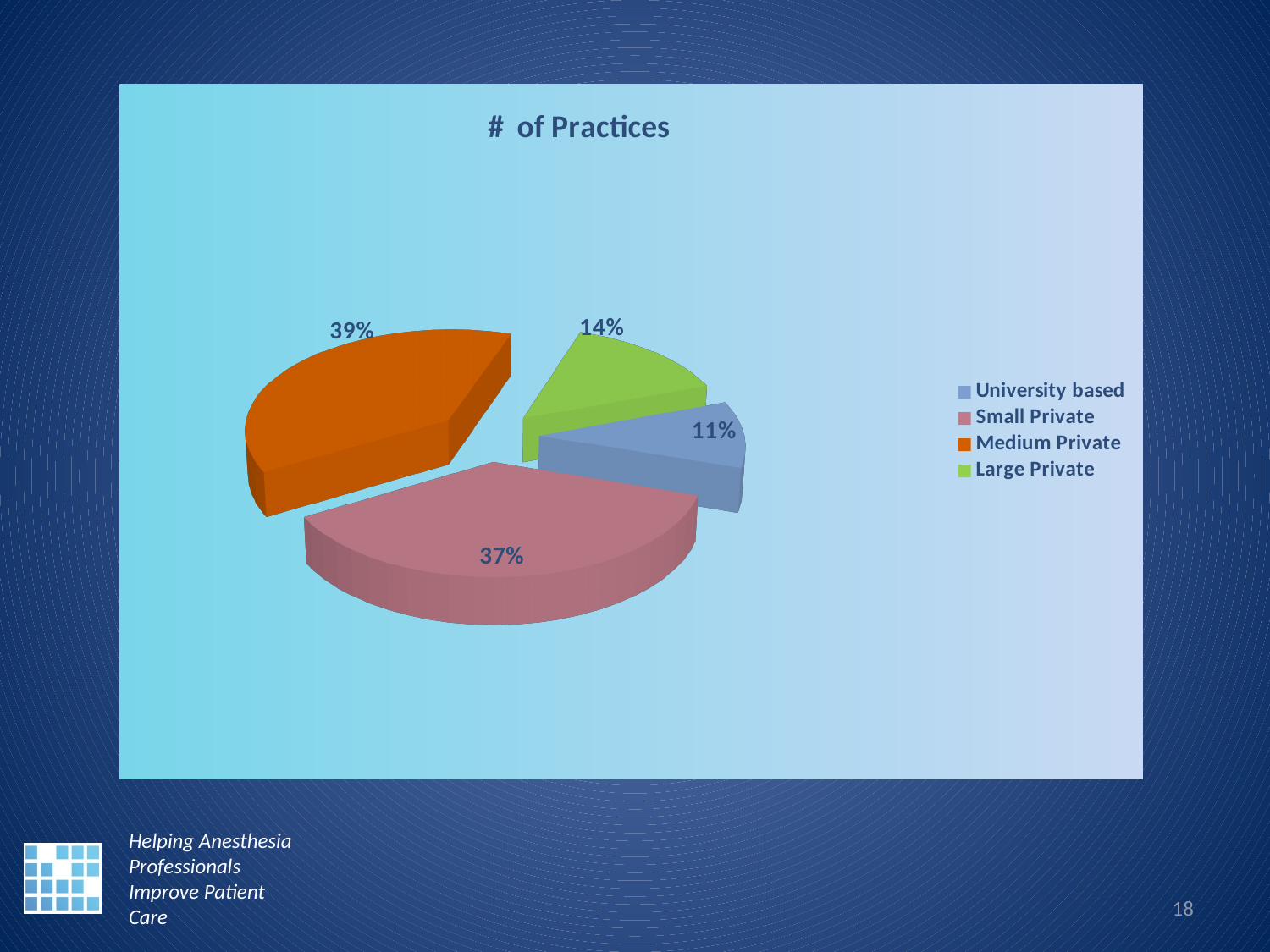
What percentage of practices are Medium Private? 39% Which category has the largest share of practices? Medium Private What kind of chart is shown on the slide? pie chart What percentage of practices are University based? 11% How many categories does the pie chart show? 4 Which category has the smallest share of practices? University based Which colour represents Small Private in the legend? pink What is the difference in percentage points between Medium Private and Small Private? 2% What percentage of practices are Large Private? 14% What is the title of the chart? # of Practices What percentage of practices are Small Private? 37% Which is larger, the share for Large Private or the share for University based? Large Private